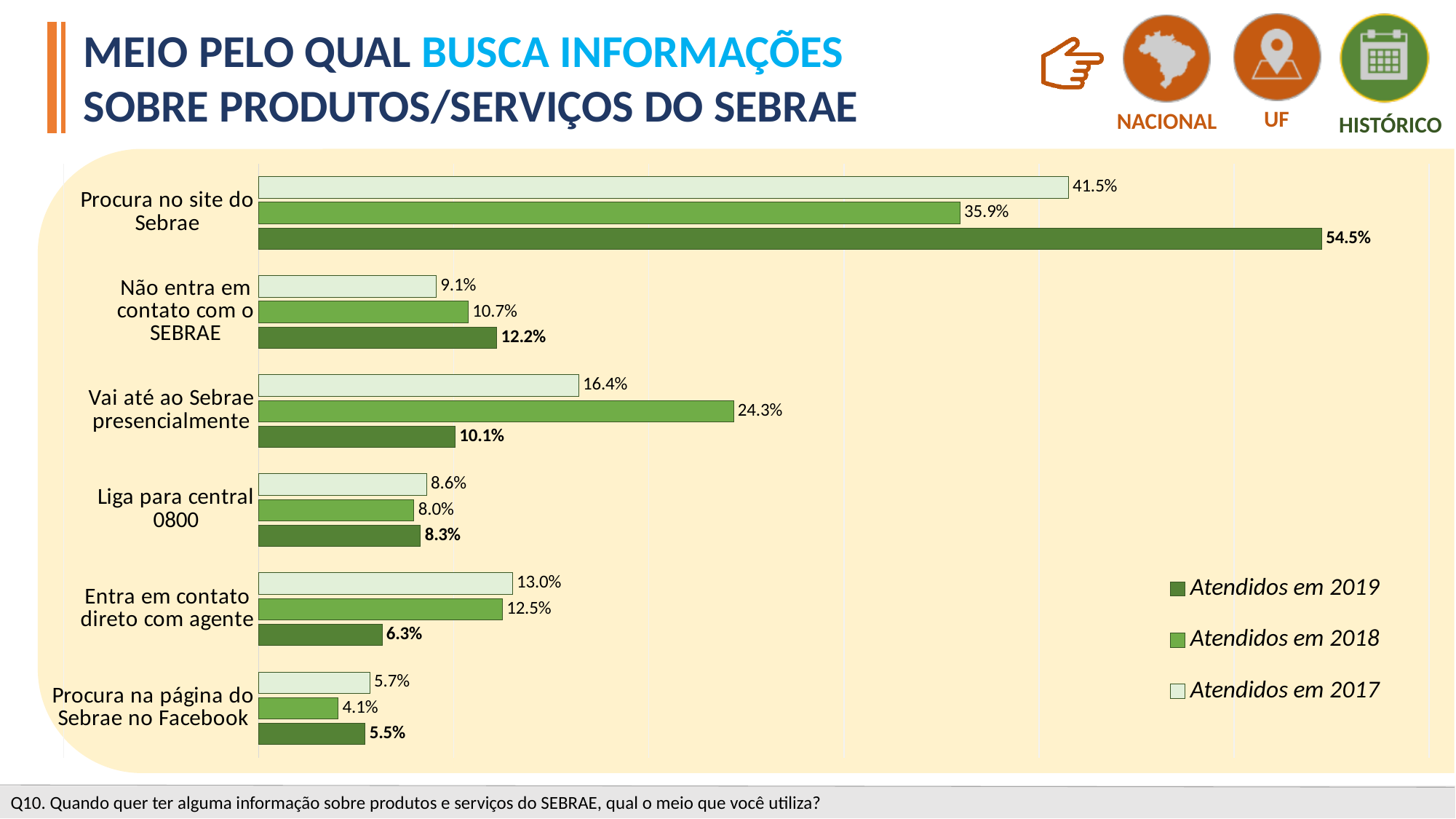
How many categories are shown on the chart? 6 What kind of chart is shown on the slide? Bar chart What is the difference between the "Atendidos em 2019" and "Atendidos em 2018" values for "Procura no site do Sebrae"? 18.6% For "Entra em contato direto com agente", which series has the larger value: "Atendidos em 2017" or "Atendidos em 2019"? Atendidos em 2017 Which category has the lowest value in the "Atendidos em 2018" series? Procura na página do Sebrae no Facebook What is the value for "Procura na página do Sebrae no Facebook" in the "Atendidos em 2017" series? 5.7% What is the value for "Procura no site do Sebrae" in the "Atendidos em 2019" series? 54.5% Which category has the highest value in the "Atendidos em 2019" series? Procura no site do Sebrae How many series does the legend list? 3 What is the value for "Vai até ao Sebrae presencialmente" in the "Atendidos em 2018" series? 24.3% Which legend entry is shown with the darkest green colour? Atendidos em 2019 What is the value for "Liga para central 0800" in the "Atendidos em 2018" series? 8.0%